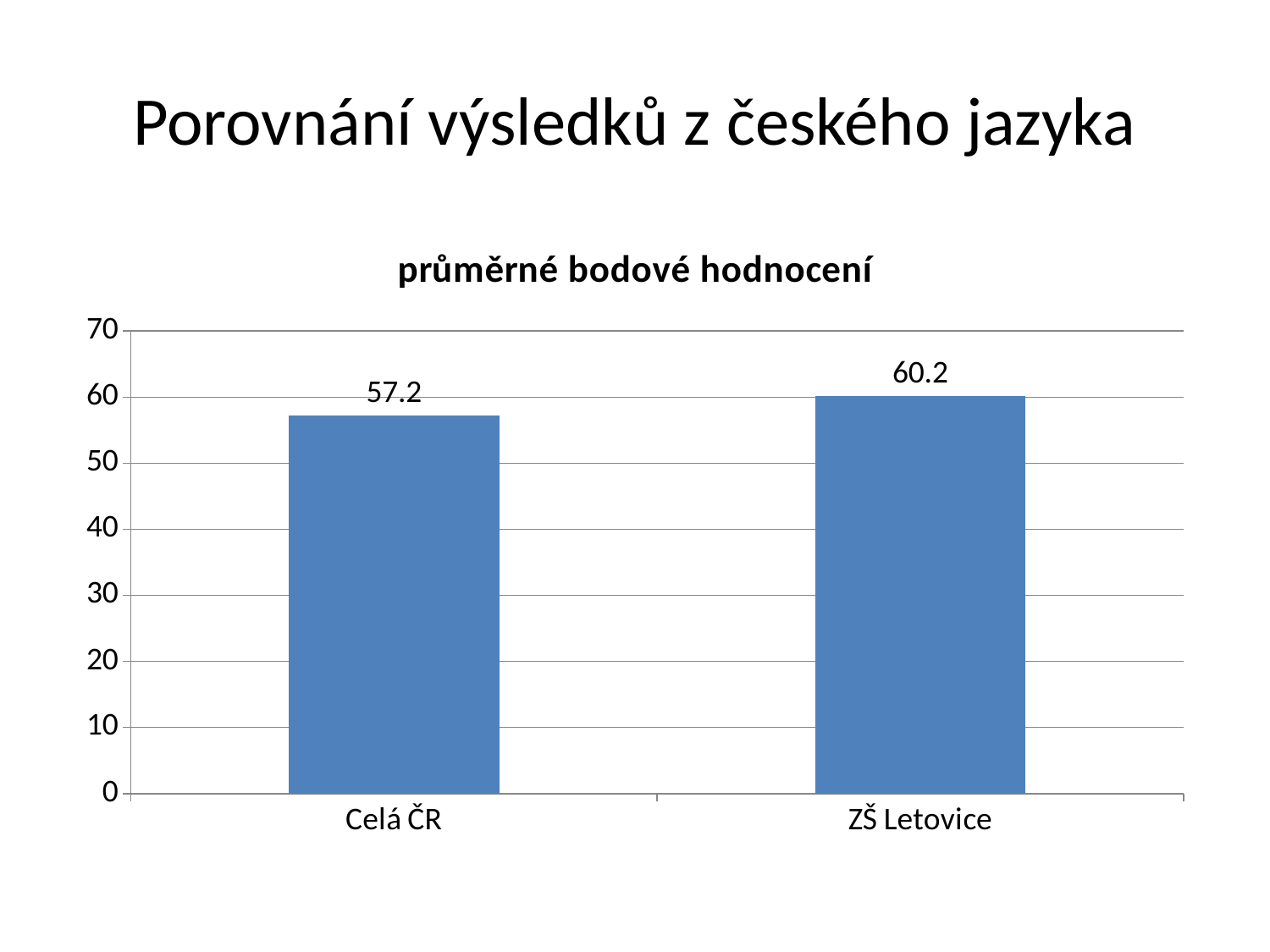
How many categories are shown on the x axis? 2 Is the value for ZŠ Letovice greater or less than 50? greater What is the highest value shown on the y axis? 70 Which category has the lowest value? Celá ČR What kind of chart is shown on the slide? bar chart What is the title of the chart? průměrné bodové hodnocení Which category has the highest value? ZŠ Letovice What is the value for Celá ČR? 57.2 What is the difference between the values for ZŠ Letovice and Celá ČR? 3 What is the value for ZŠ Letovice? 60.2 Is the value for Celá ČR greater or less than 60? less Which is larger, the value for Celá ČR or the value for ZŠ Letovice? ZŠ Letovice